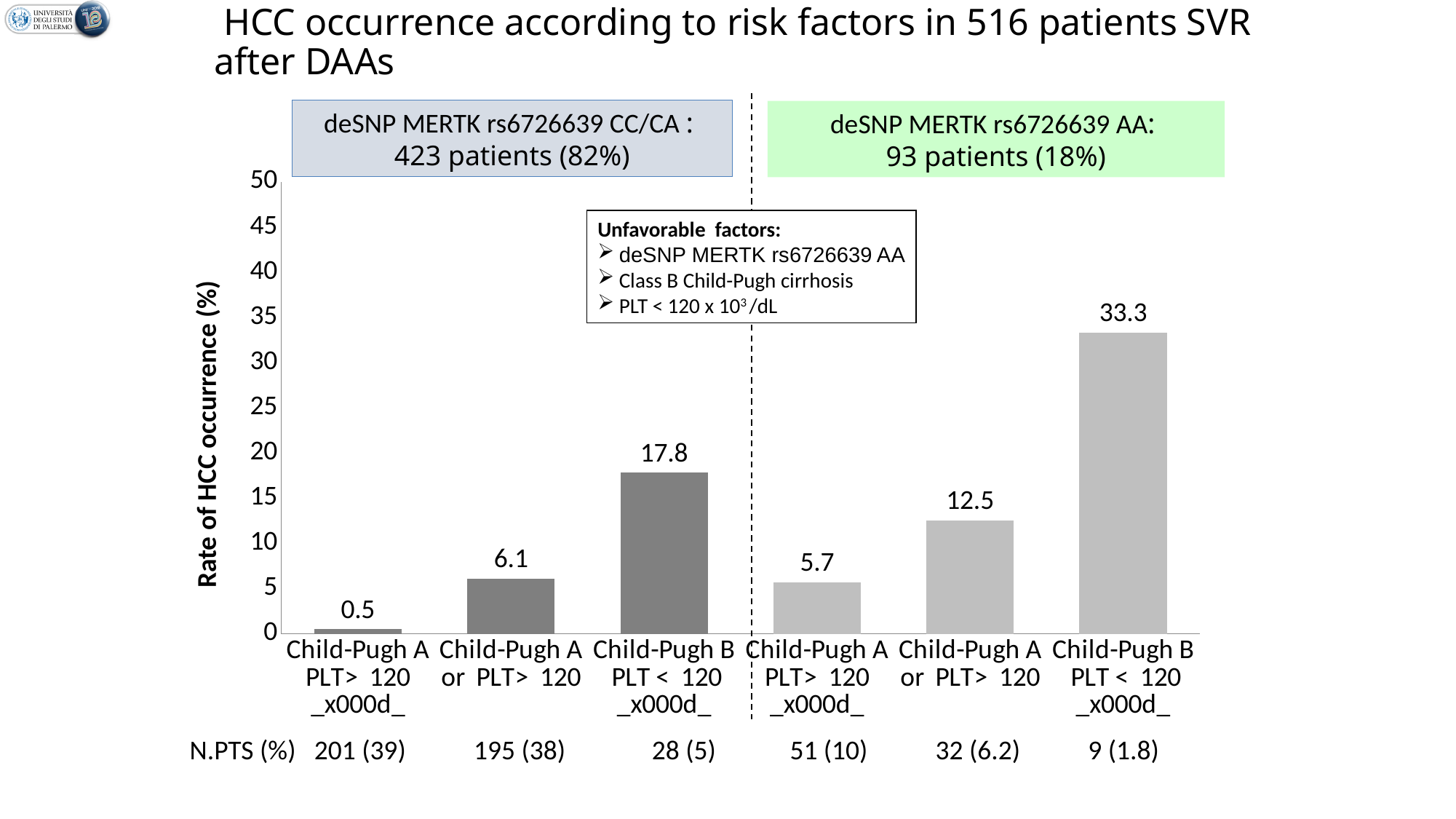
Which bar has the lowest rate of HCC occurrence? Child-Pugh A PLT > 120 in the CC/CA group What kind of chart is shown on the slide? Bar chart What is the rate of HCC occurrence for Child-Pugh B PLT < 120 patients in the CC/CA group? 17.8 How many bars are plotted in the chart? 6 What is the rate of HCC occurrence for Child-Pugh A PLT > 120 patients in the deSNP MERTK rs6726639 CC/CA group? 0.5 Which bar has the highest rate of HCC occurrence? Child-Pugh B PLT < 120 in the AA group What is the label of the vertical axis of the chart? Rate of HCC occurrence (%) What is the difference in HCC occurrence rate between Child-Pugh B PLT < 120 patients in the AA group and in the CC/CA group? 15.5 What is the rate of HCC occurrence for Child-Pugh B PLT < 120 patients in the deSNP MERTK rs6726639 AA group? 33.3 Which is larger: the HCC occurrence rate for Child-Pugh A or PLT > 120 in the CC/CA group, or for Child-Pugh A PLT > 120 in the AA group? Child-Pugh A or PLT > 120 in the CC/CA group Within the AA group, do the HCC occurrence rates rise or fall from left to right across the three categories? Rise What is the rate of HCC occurrence for Child-Pugh A or PLT > 120 patients in the AA group? 12.5